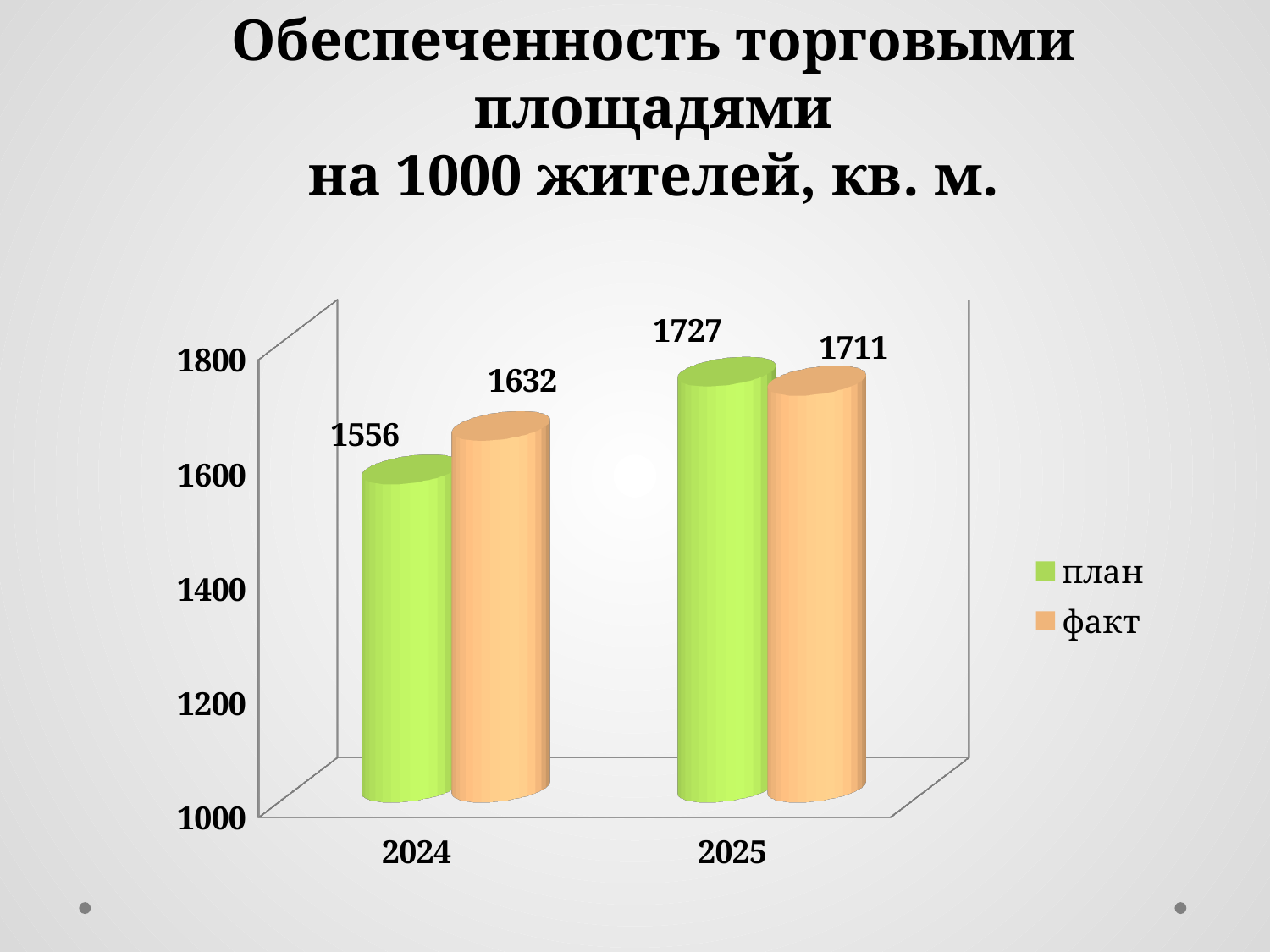
What kind of chart is shown on the slide? bar chart Does the план value rise or fall from 2024 to 2025? rise Which year has the lowest факт value? 2024 What is the difference between the факт and план values for 2024? 76 How many series does the legend list? 2 What is the факт value for 2024? 1632 What is the план value for 2025? 1727 What is the difference between the план and факт values for 2025? 16 Which year has the highest план value? 2025 What is the план value for 2024? 1556 Which is larger in 2024, план or факт? факт What is the факт value for 2025? 1711